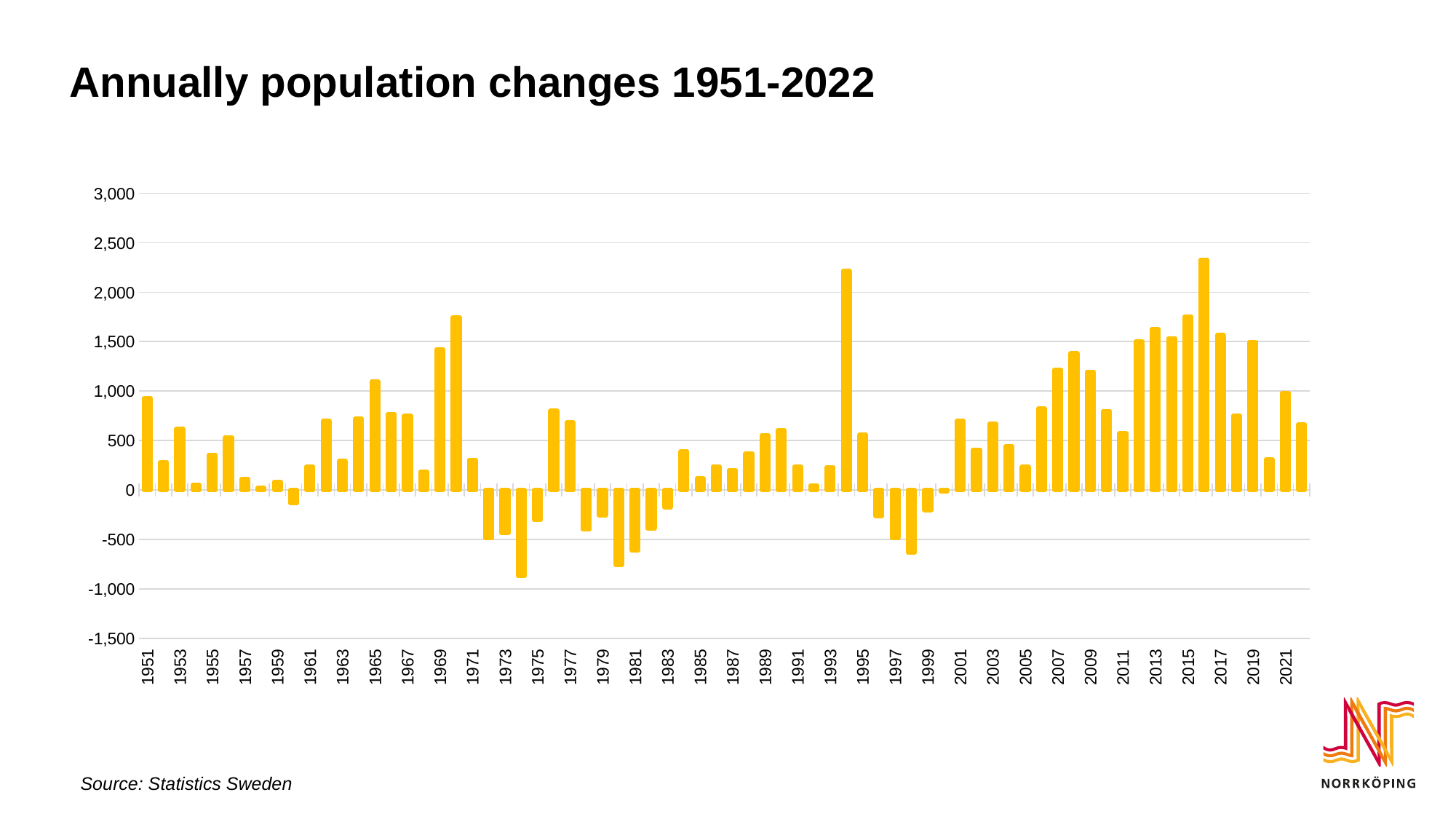
Which year between 1951 and 1959 has the highest value? 1951 Do the values rise or fall from 2005 to 2007? rise Is the value for 1994 greater or less than 2,000? greater Which year has the larger value, 1969 or 1994? 1994 Is the value for 2007 greater or less than 1,000? greater Is the value for 1951 greater or less than 500? greater Which year has the larger value, 2019 or 2021? 2019 What source is cited for the chart data? Statistics Sweden What is the title of the chart? Annually population changes 1951-2022 What kind of chart is shown on the slide? bar chart